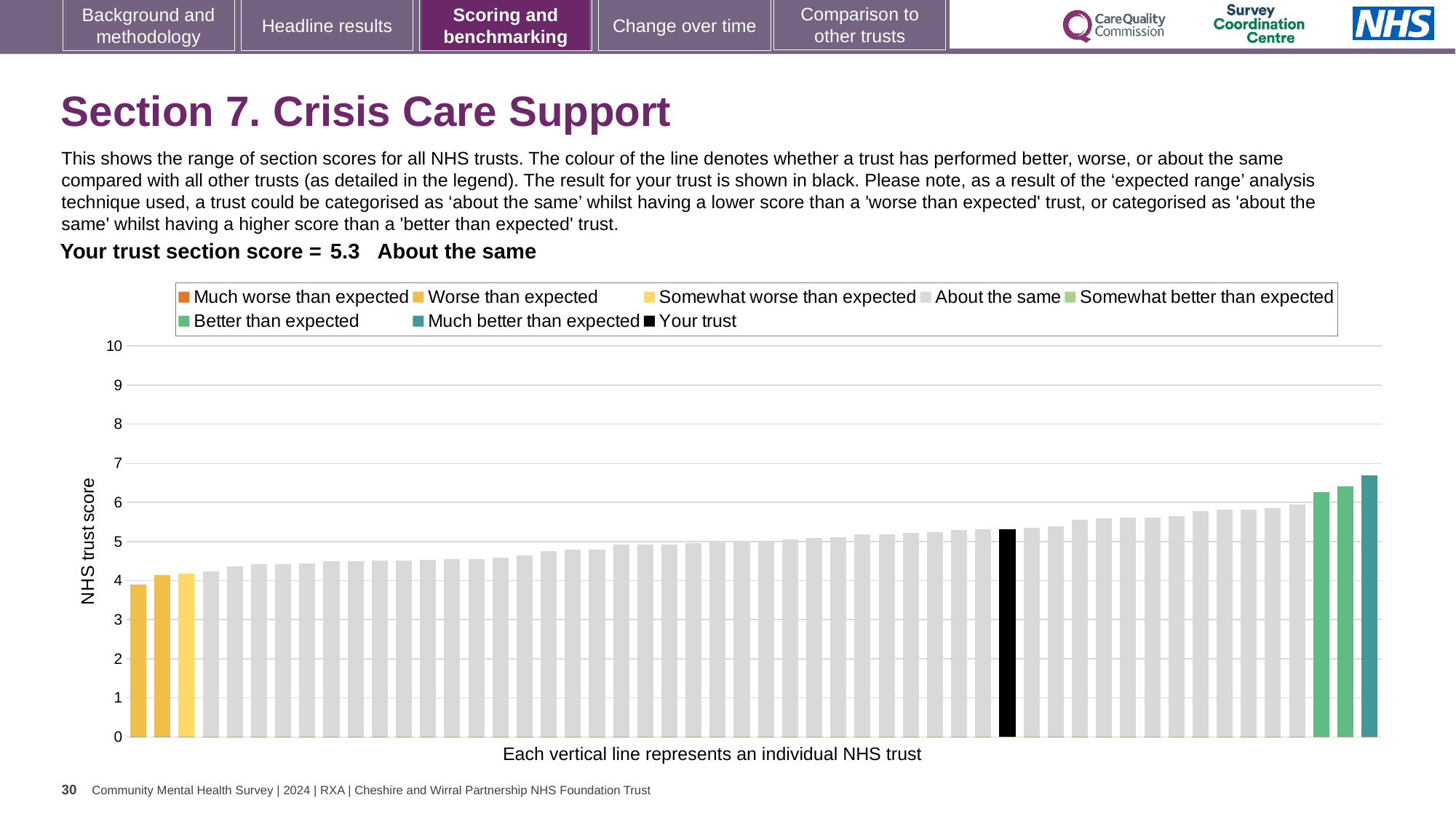
What is the label on the vertical axis of the chart? NHS trust score How many bars are coloured black for 'Your trust'? 1 What kind of chart is shown on the slide? bar chart Do the bar values rise or fall from left to right along the x axis? rise Is the value of the tallest bar greater or less than 7? less How many entries does the chart legend list? 8 Is the value of the shortest bar greater or less than 5? less Is the value of the black 'Your trust' bar greater or less than 5? greater Which category is your trust's section score placed in, according to the slide? About the same What is the section score for your trust shown on the slide? 5.3 How many bars are coloured in the 'Worse than expected' or 'Somewhat worse than expected' yellow shades? 3